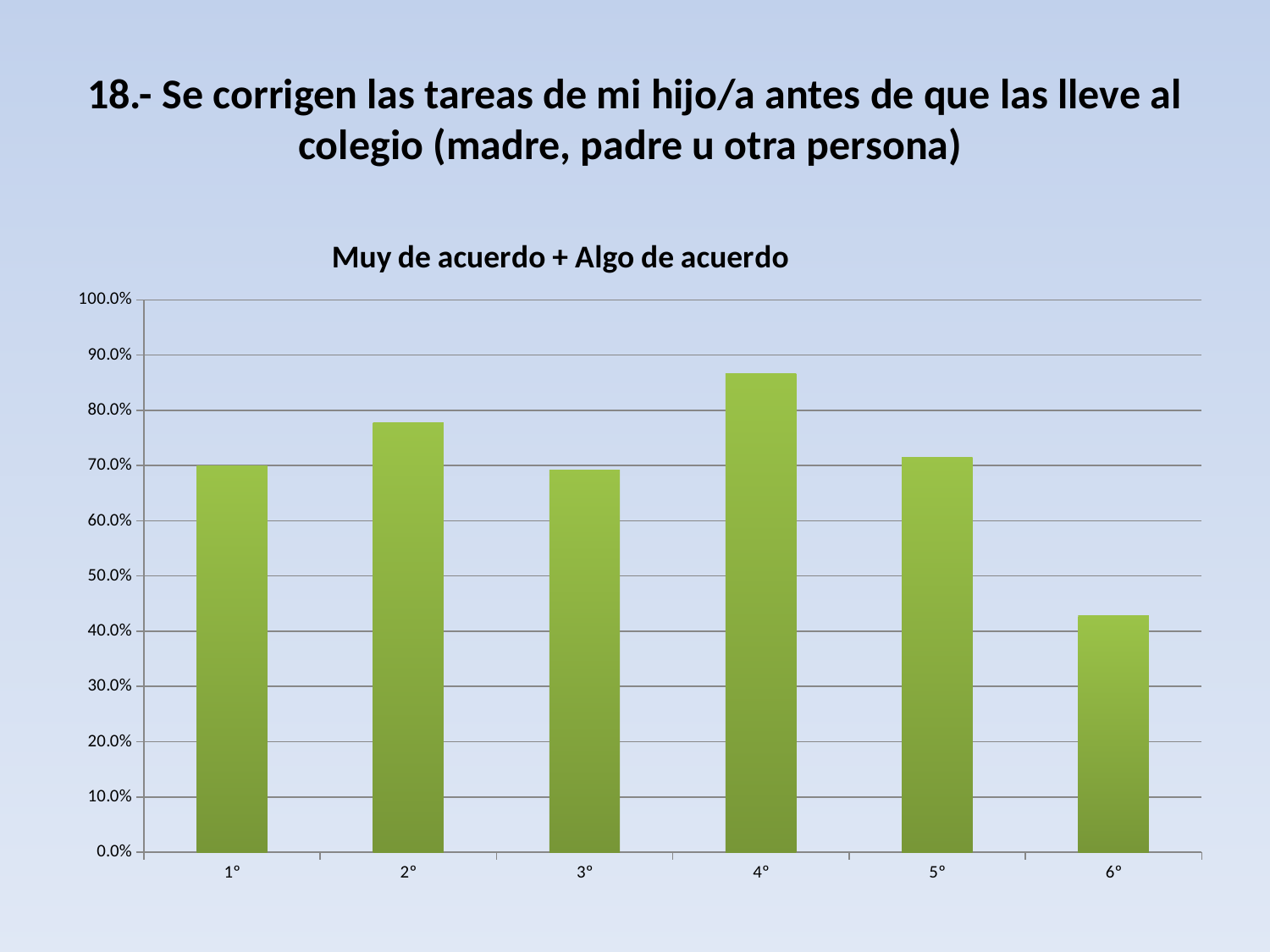
Which has a larger value, 2° or 3°? 2° Is the value for 5° greater or less than 60.0%? greater Is the value for 6° greater or less than 50.0%? less Is the value for 2° greater or less than 70.0%? greater How many categories are shown on the x axis of the chart? 6 Which category has the lowest value in the chart? 6° What is the title of the chart? Muy de acuerdo + Algo de acuerdo Which has a larger value, 5° or 6°? 5° Which category has the highest value in the chart? 4° What kind of chart is shown on the slide? bar chart